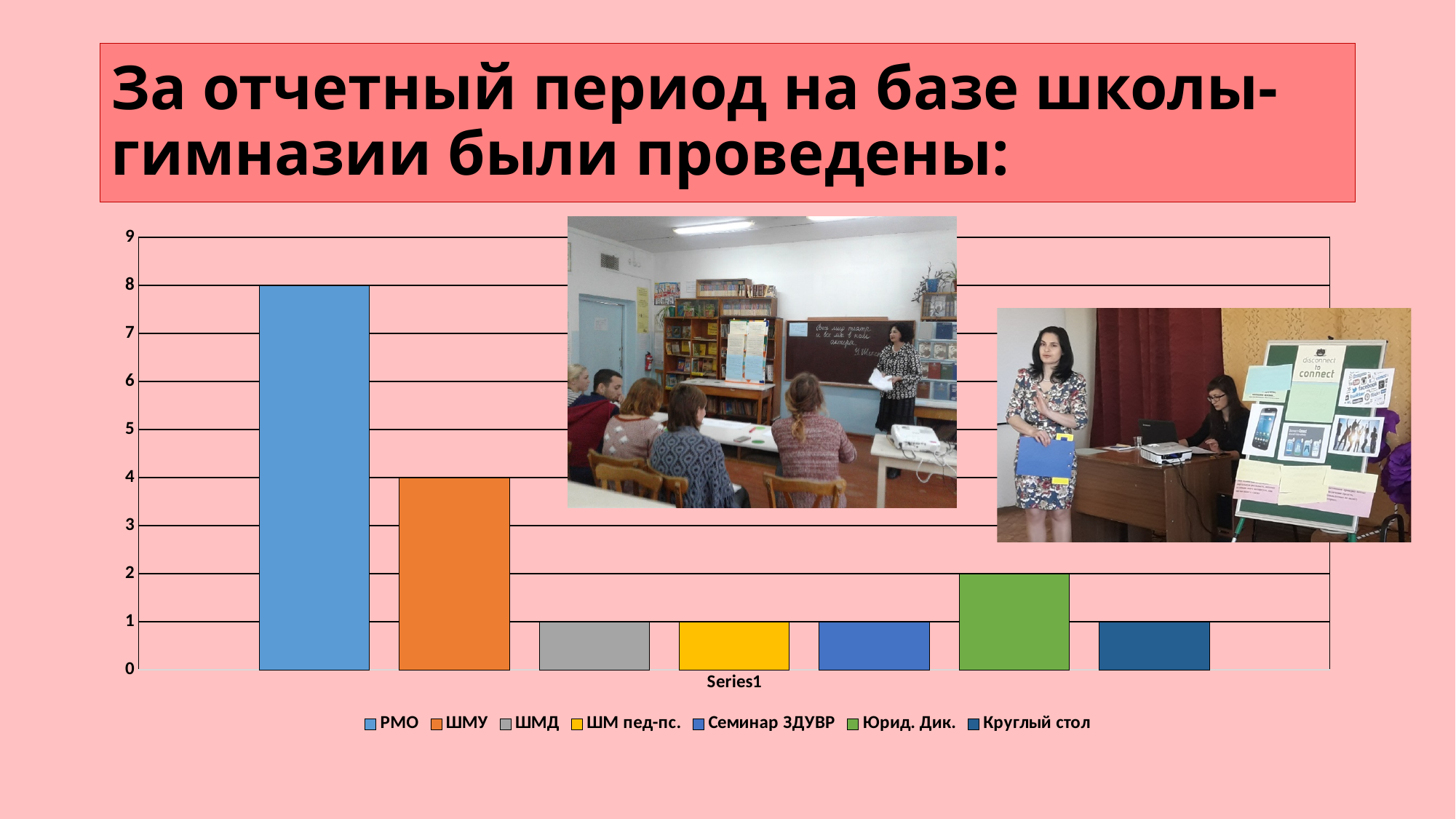
Is the value for РМО greater or less than 5? greater Which is larger, the value for ШМУ or the value for Юрид. Дик.? ШМУ What is the value for Круглый стол? 1 How many categories have a value of 1? 4 What colour is the bar for ШМ пед-пс.? yellow What is the value for ШМУ? 4 How many categories does the legend list? 7 What is the difference between the values for РМО and ШМУ? 4 Which category has the highest value? РМО What is the value for Юрид. Дик.? 2 What kind of chart is shown on the slide? bar chart What is the value for РМО? 8